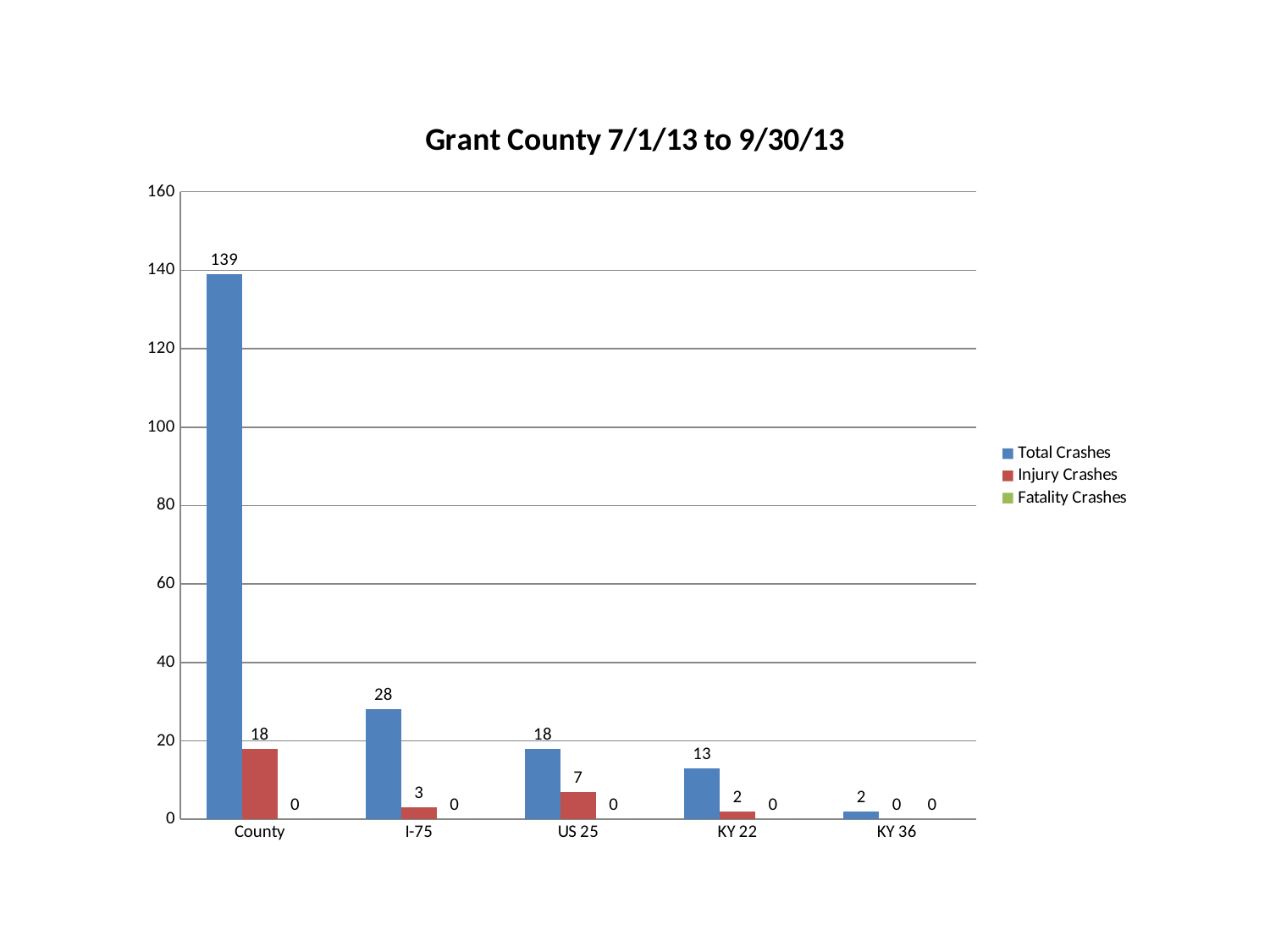
Which category has the highest Total Crashes? County What kind of chart is shown on the slide? bar chart How many series does the legend list? 3 Which is larger: Injury Crashes for County or Injury Crashes for US 25? Injury Crashes for County How many categories are shown on the x axis? 5 What is the value of Fatality Crashes for I-75? 0 Is the value of Total Crashes for County greater or less than 120? greater What is the value of Total Crashes for County? 139 What is the value of Injury Crashes for US 25? 7 What is the difference between Total Crashes for I-75 and Total Crashes for US 25? 10 Which category has the lowest Total Crashes? KY 36 What is the title of the chart? Grant County 7/1/13 to 9/30/13